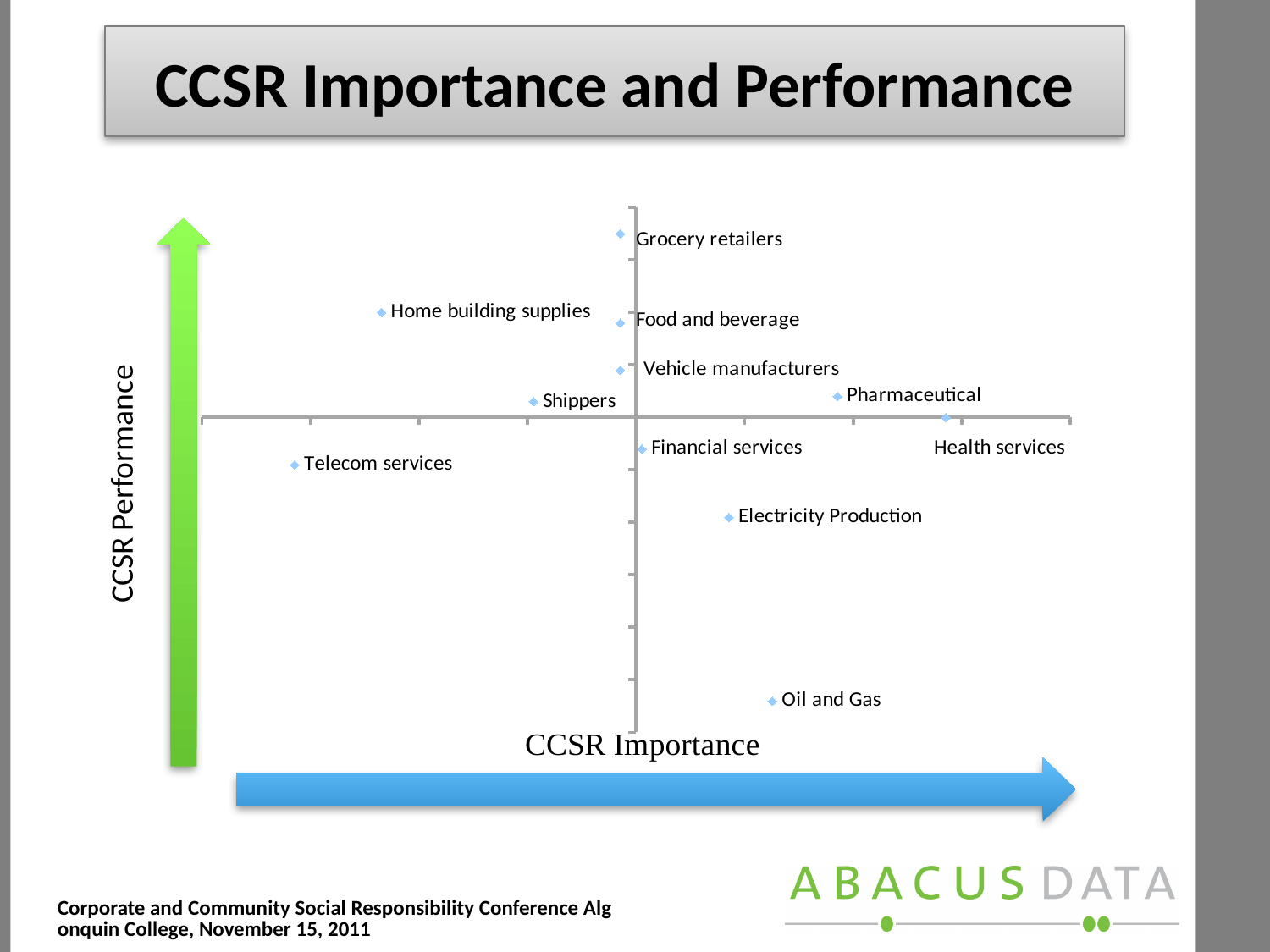
Which has higher CCSR Performance, Pharmaceutical or Financial services? Pharmaceutical Which has higher CCSR Performance, Home building supplies or Telecom services? Home building supplies What is the label of the vertical axis of the chart? CCSR Performance Which industry has the lowest CCSR Importance on the chart? Telecom services Which has lower CCSR Performance, Electricity Production or Oil and Gas? Oil and Gas How many industries are plotted as points on the chart? 11 What kind of chart is shown on the slide? Scatter chart Which industry has the highest CCSR Importance on the chart? Health services Which industry has the highest CCSR Performance on the chart? Grocery retailers What is the title of the chart on the slide? CCSR Importance and Performance Which industry has the lowest CCSR Performance on the chart? Oil and Gas